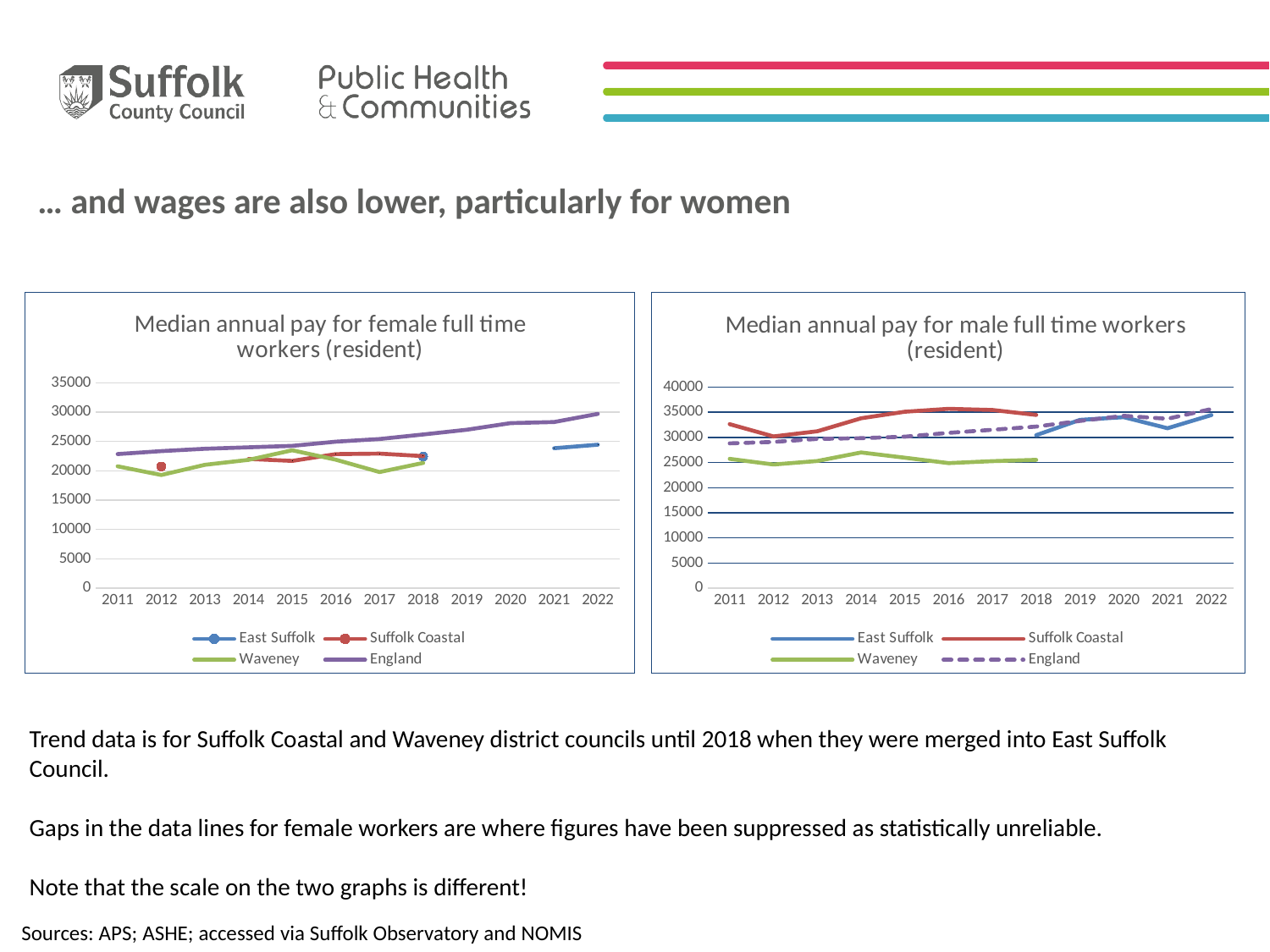
In the 'Median annual pay for female full time workers (resident)' chart, is the value for East Suffolk in 2022 greater or less than 25000? less In the 'Median annual pay for male full time workers (resident)' chart, which series is drawn with a dashed line? England In the 'Median annual pay for female full time workers (resident)' chart, is the value for England in 2011 greater or less than 20000? greater In the 'Median annual pay for female full time workers (resident)' chart, which is larger in 2017: Suffolk Coastal or Waveney? Suffolk Coastal What kind of chart is the 'Median annual pay for female full time workers (resident)' chart? line chart In the 'Median annual pay for male full time workers (resident)' chart, which series has the lowest value in 2014? Waveney In the 'Median annual pay for female full time workers (resident)' chart, does the England line rise or fall from 2011 to 2022? rise In the 'Median annual pay for male full time workers (resident)' chart, is the value for Waveney in 2014 greater or less than 25000? greater How many series does the legend of the 'Median annual pay for male full time workers (resident)' chart list? 4 How many years are shown on the x axis of the 'Median annual pay for female full time workers (resident)' chart? 12